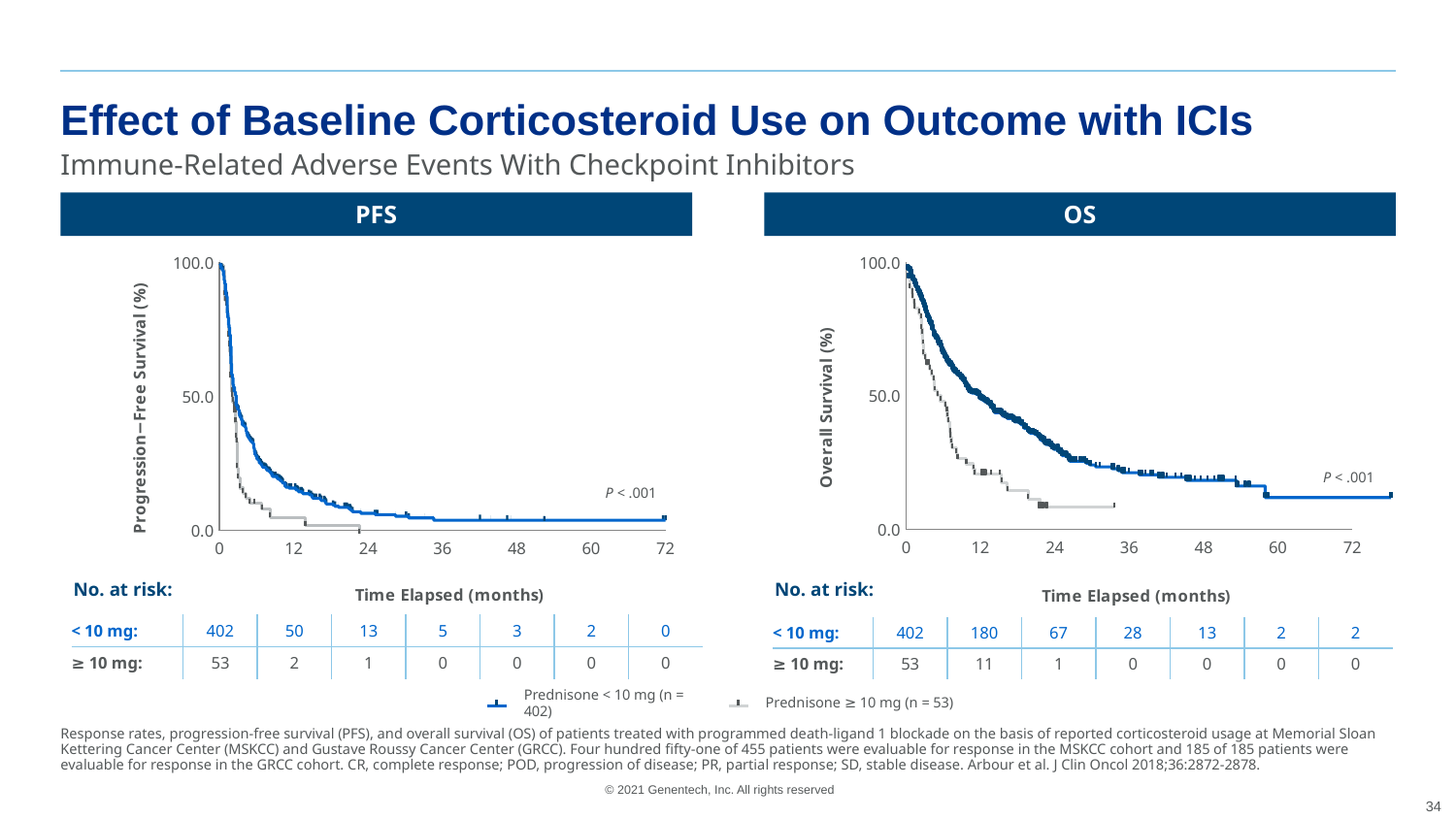
In the PFS chart, which group has more patients at risk at 24 months, < 10 mg or ≥ 10 mg? < 10 mg In the OS chart, what is the number at risk for the ≥ 10 mg group at 12 months? 11 In the OS chart, what is the difference between the number at risk for the < 10 mg group and the ≥ 10 mg group at 12 months? 169 In the OS chart, is the overall survival for the ≥ 10 mg group at 12 months greater or less than 50.0? less What is the x-axis label of the PFS chart? Time Elapsed (months) In the OS chart, what is the number at risk for the < 10 mg group at 24 months? 67 In the PFS chart, what is the number at risk for the ≥ 10 mg group at 0 months? 53 In the PFS chart, is the progression-free survival for the < 10 mg group at 12 months greater or less than 50.0? less In the PFS chart, what is the number at risk for the < 10 mg group at 12 months? 50 How many series does the legend list? 2 What kind of chart is the PFS chart? line chart What P value is shown on the OS chart? P < .001